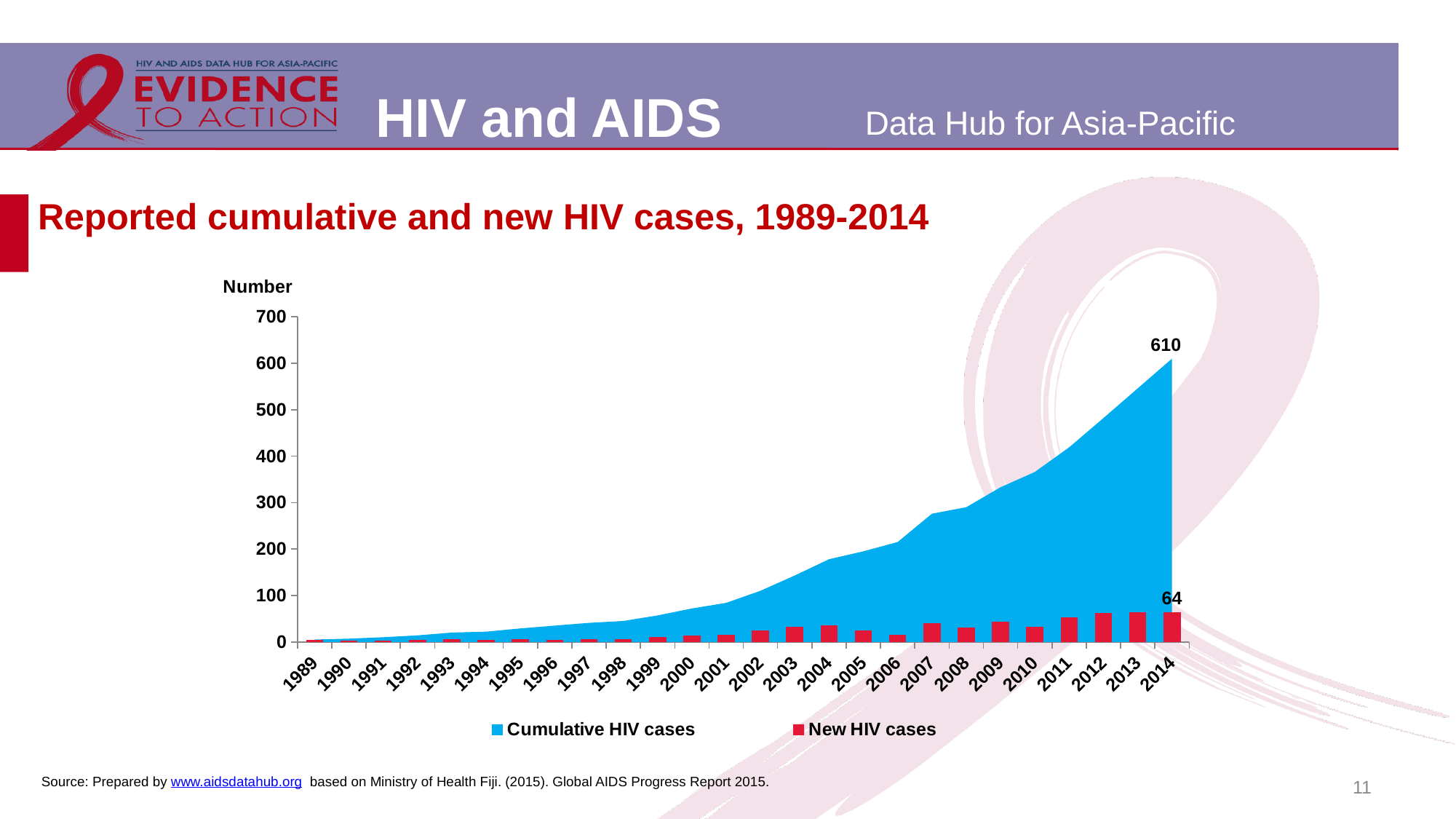
How many series does the legend list? 2 Which year has the highest value of Cumulative HIV cases? 2014 What kind of chart is used to show the New HIV cases series? Bar chart Is the value for Cumulative HIV cases in 2004 greater or less than 200? less Which is larger in 2014, Cumulative HIV cases or New HIV cases? Cumulative HIV cases What is the value of New HIV cases in 2014? 64 How many years are shown on the x axis? 26 What is the difference between Cumulative HIV cases and New HIV cases in 2014? 546 What is the label on the vertical axis? Number What is the value of Cumulative HIV cases in 2014? 610 Is the value for Cumulative HIV cases in 2010 greater or less than 300? greater Do Cumulative HIV cases rise or fall from 1989 to 2014? Rise